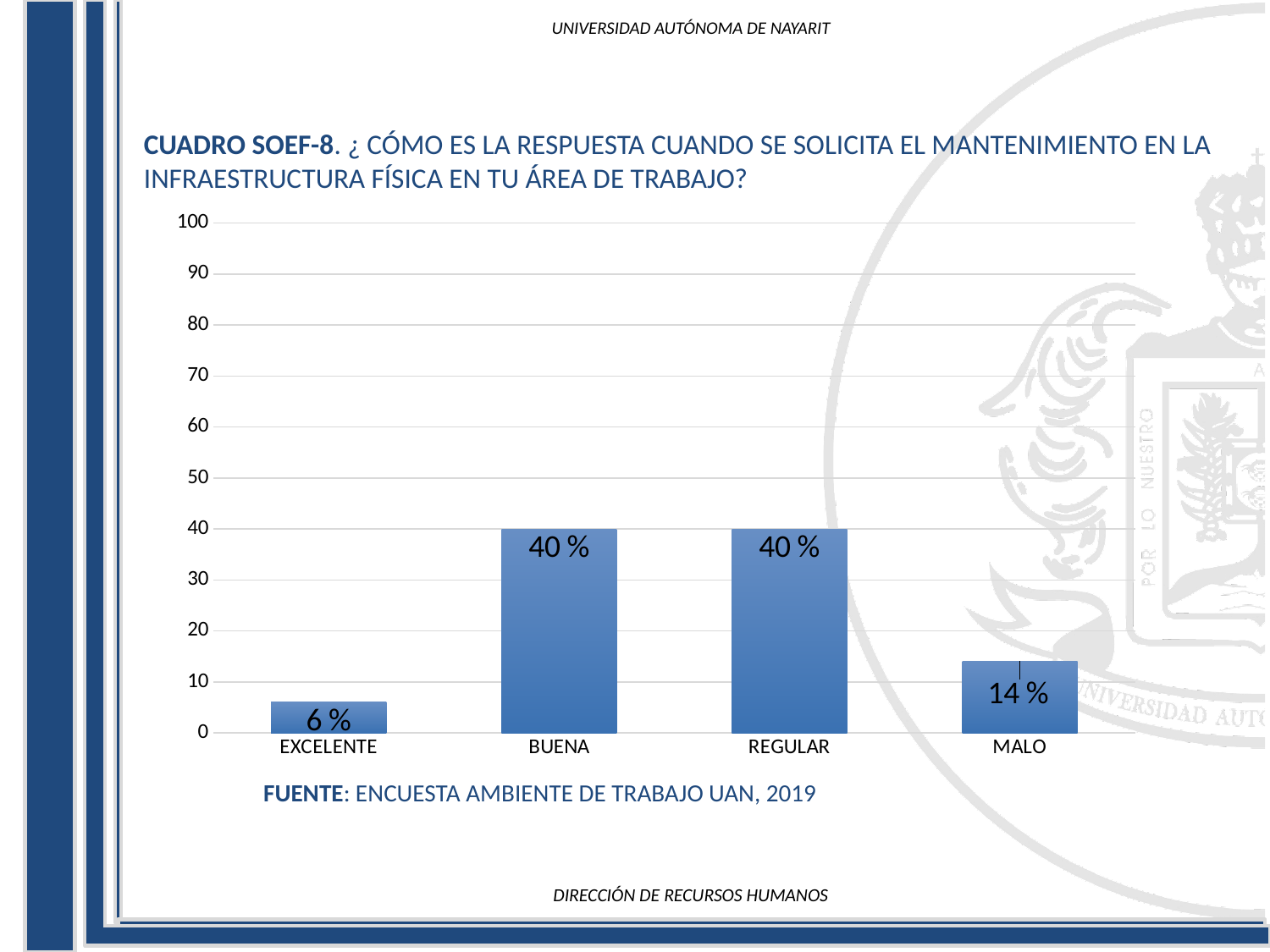
Is the value for MALO greater or less than 20? less What is the value for BUENA? 40 % What is the difference between the values for MALO and EXCELENTE? 8 % How many categories are shown on the x axis? 4 Which category has the lowest value? EXCELENTE What kind of chart is shown on the slide? bar chart What is the highest value shown on the y axis? 100 Which is larger, the value for REGULAR or the value for MALO? REGULAR What is the difference between the values for BUENA and MALO? 26 % What is the source cited below the chart? ENCUESTA AMBIENTE DE TRABAJO UAN, 2019 What is the value for MALO? 14 % What is the value for EXCELENTE? 6 %